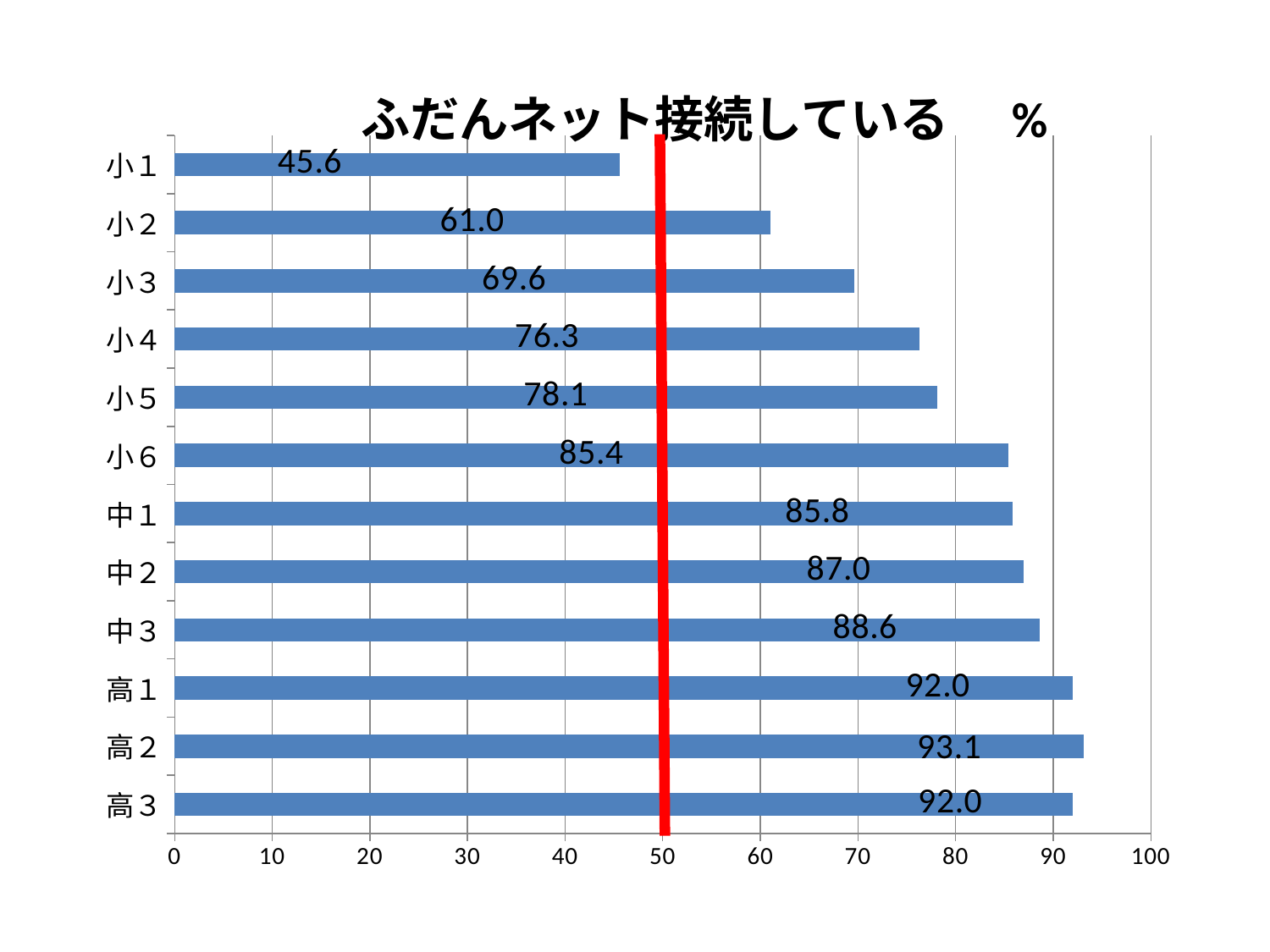
What kind of chart is shown on the slide? bar chart What is the value for 小１? 45.6 How many categories are shown on the chart? 12 What is the title of the chart? ふだんネット接続している ％ Which category has the highest value? 高２ Which is larger, the value for 小３ or the value for 中１? 中１ Which category has the lowest value? 小１ Is the value for 小１ greater or less than 50? less Do the values generally rise or fall from 小１ to 高２? rise What is the difference between the values for 小６ and 小１? 39.8 What is the value for 中２? 87.0 What is the value for 高２? 93.1